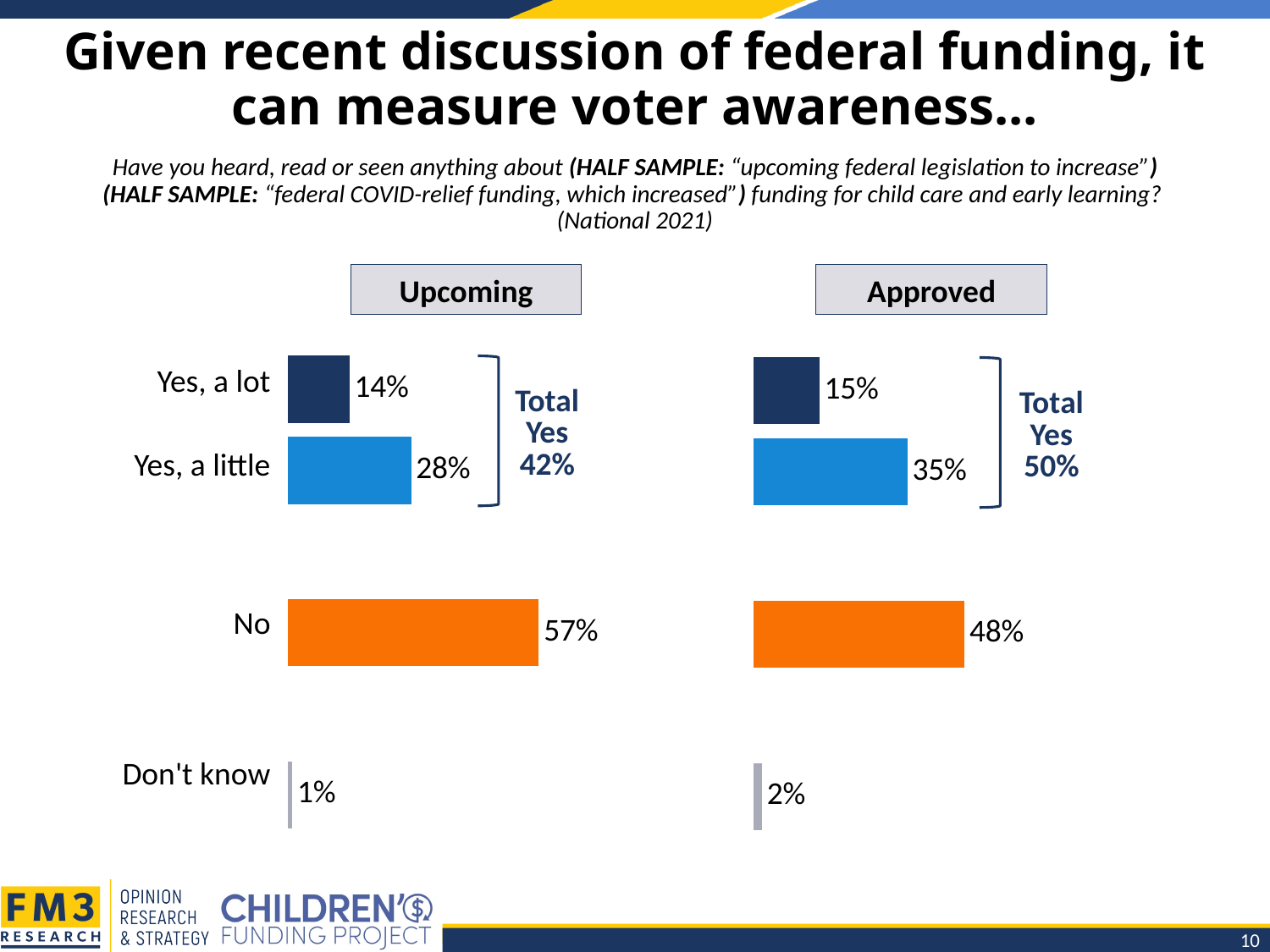
What is the Total Yes shown for the Upcoming chart? 42% Which is larger: "Yes, a little" in the Upcoming chart or "Yes, a little" in the Approved chart? Approved (35%) In the Approved chart, what is the value for "Don't know"? 2% In the Upcoming chart, what is the value for "Yes, a lot"? 14% In the Approved chart, what is the value for "Yes, a little"? 35% In the Upcoming chart, what is the value for "No"? 57% How many categories are shown in the Upcoming chart? 4 What type of chart is used on this slide? Bar chart In the Approved chart, which category has the highest value? No What is the difference between the "No" values in the Upcoming chart and the Approved chart? 9 percentage points What is the Total Yes shown for the Approved chart? 50% In the Upcoming chart, which category has the lowest value? Don't know